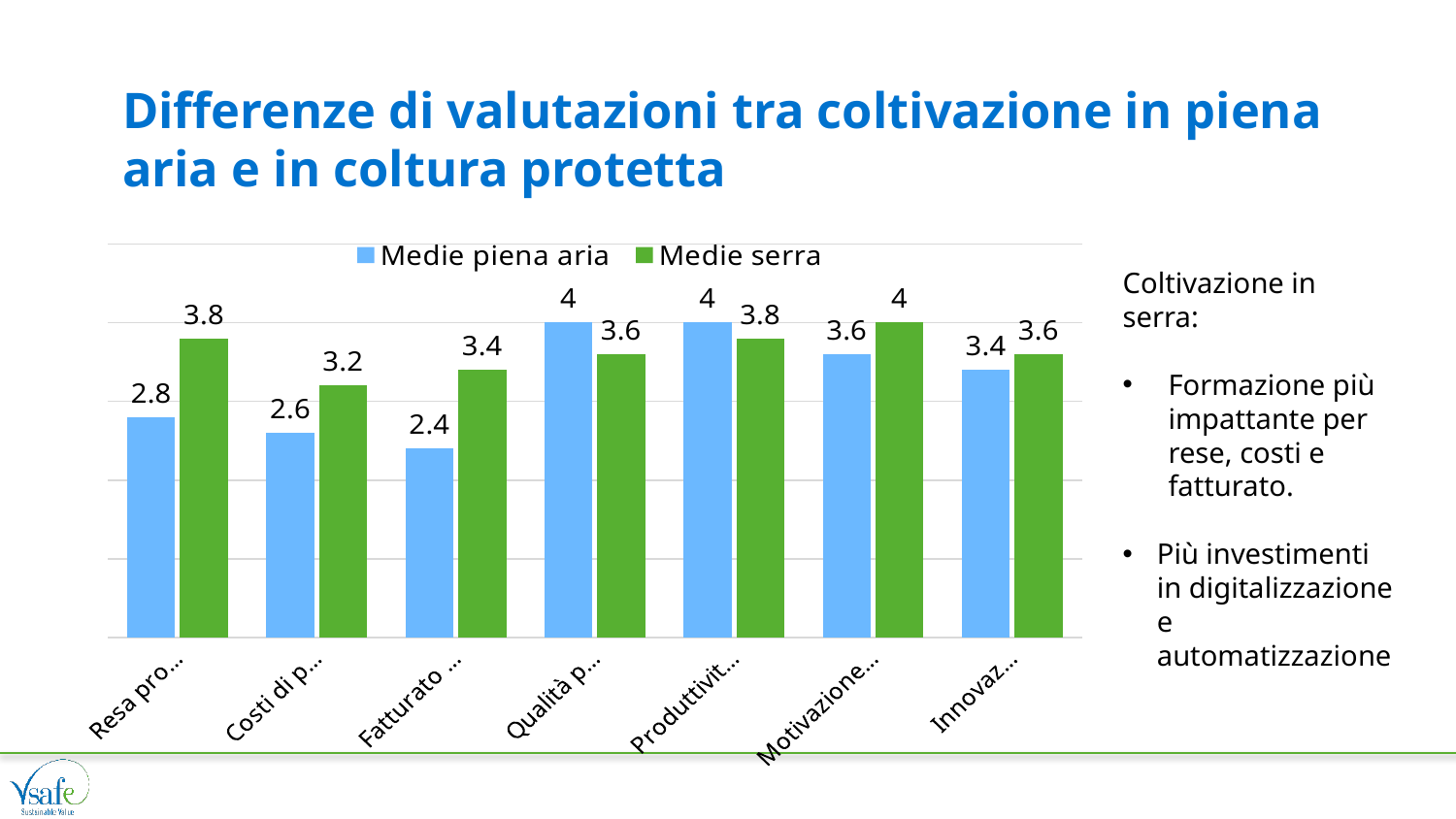
What type of chart is shown on the slide? Bar chart Which category has the lowest Medie piena aria value? Fatturato ... For the category labelled "Produttivit...", which is larger: Medie piena aria or Medie serra? Medie piena aria What is the value of Medie serra for the last category, labelled "Innovaz..."? 3.6 How many series does the legend list? 2 How many categories are shown on the x axis? 7 What is the value of Medie piena aria for the category labelled "Qualità p..."? 4 Which category has the lowest Medie serra value? Costi di p... What is the value of Medie serra for the category labelled "Fatturato ..."? 3.4 What is the value of Medie piena aria for the first category, labelled "Resa pro..."? 2.8 Which category has the highest Medie serra value? Motivazione... What is the difference between Medie serra and Medie piena aria for the category labelled "Resa pro..."? 1